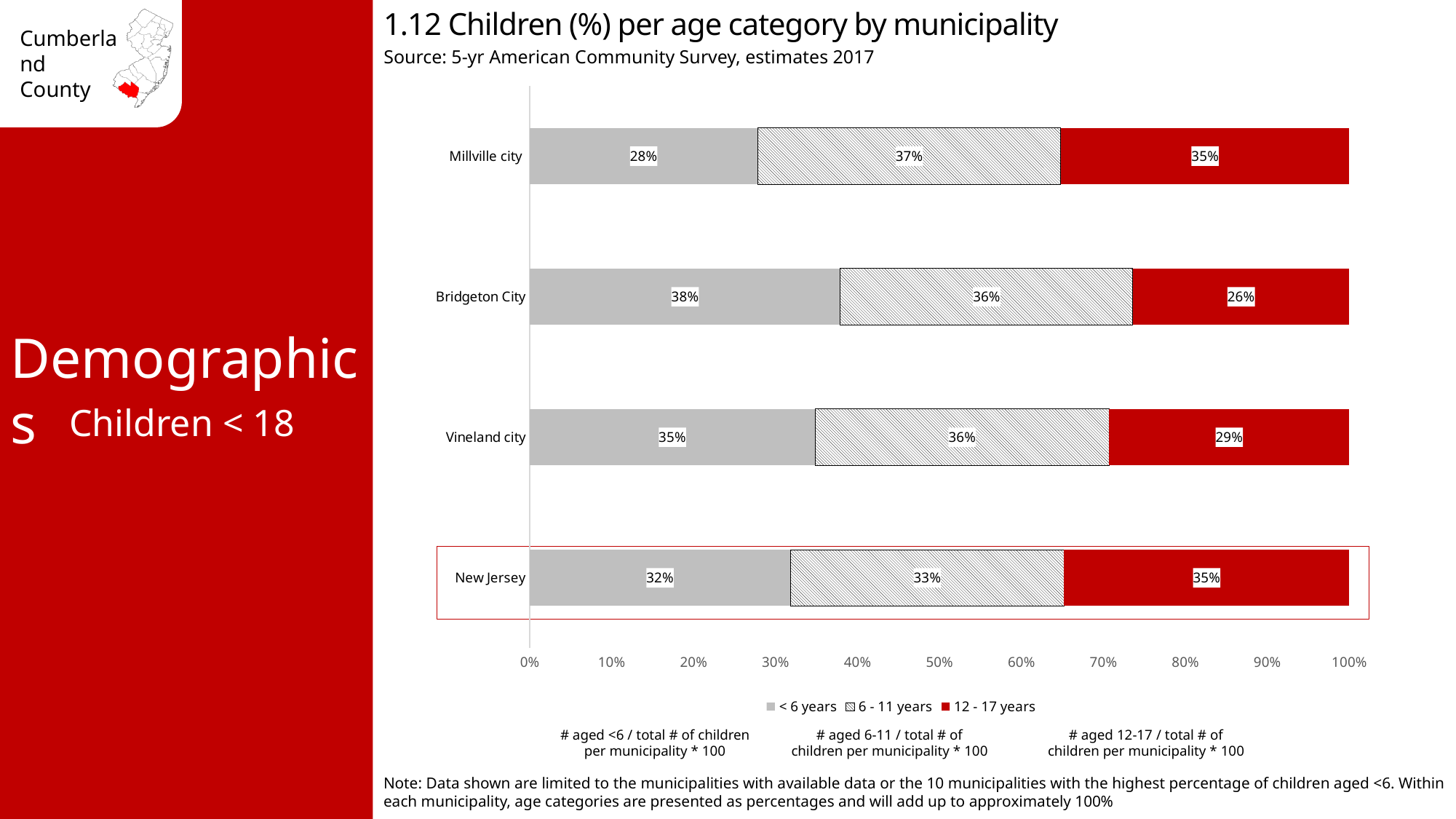
What is the value for 6 - 11 years in New Jersey? 33% What is the difference between the < 6 years values for Bridgeton City and Millville city? 10% How many series does the legend list? 3 What percentage of children in Millville city are aged 6 - 11 years? 37% Which municipality has the lowest percentage of children aged 12 - 17 years? Bridgeton City Which is larger: the 12 - 17 years value for Millville city or for Vineland city? Millville city How many municipalities or regions are shown on the chart? 4 What kind of chart is shown on the slide? Stacked bar chart Which series is shown in red? 12 - 17 years Which municipality has the highest percentage of children aged < 6 years? Bridgeton City What percentage of children in Vineland city are aged 12 - 17 years? 29% What is the value for < 6 years in Bridgeton City? 38%